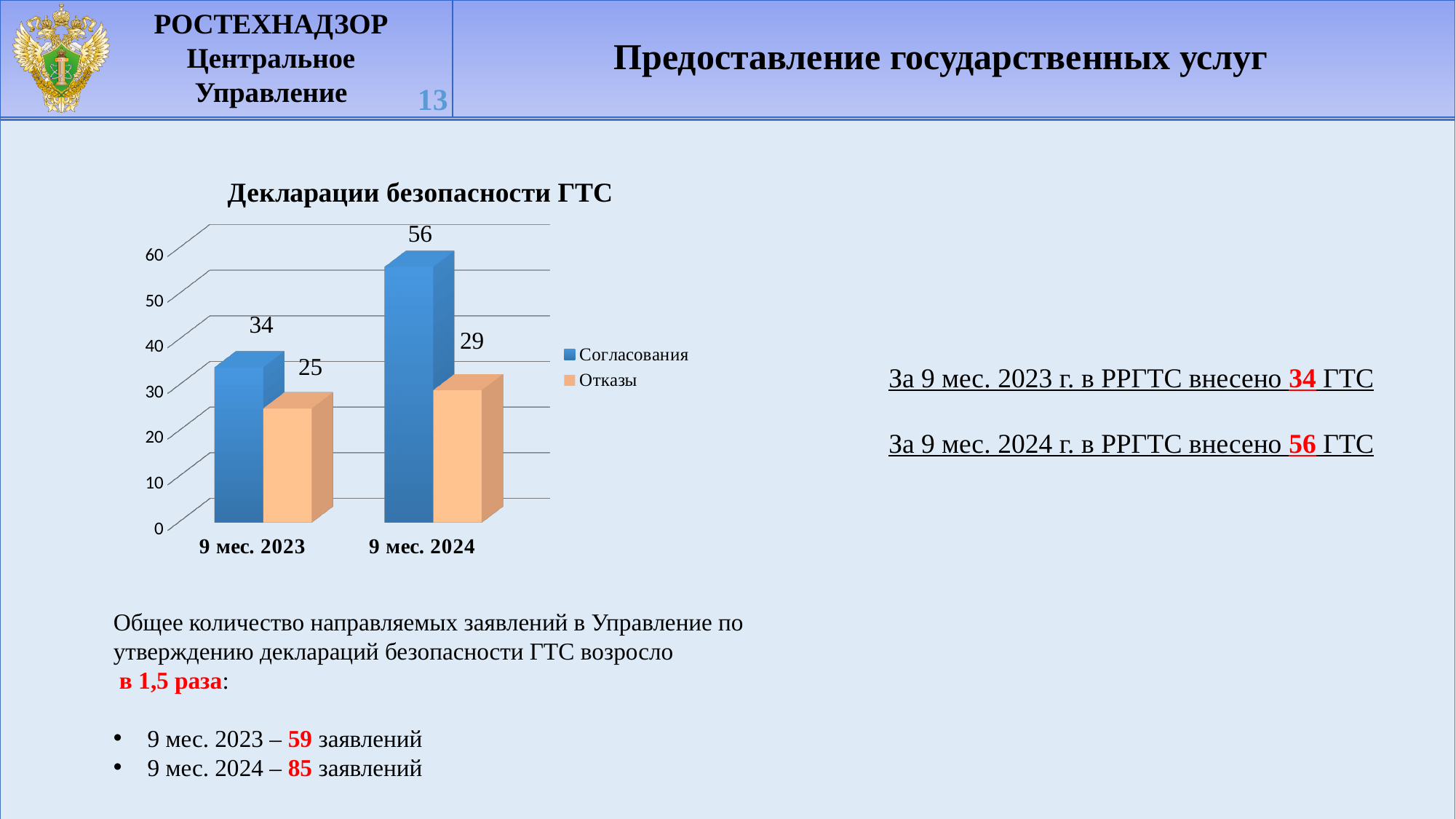
How many series does the legend list? 2 What is the value of Согласования for 9 мес. 2024? 56 What is the value of Отказы for 9 мес. 2023? 25 What is the difference between Согласования for 9 мес. 2024 and 9 мес. 2023? 22 What kind of chart is shown? bar chart Which category has the highest value for Согласования? 9 мес. 2024 What is the title of the chart? Декларации безопасности ГТС Which is larger: Согласования or Отказы for 9 мес. 2024? Согласования What is the value of Согласования for 9 мес. 2023? 34 How many categories are shown on the x axis? 2 Which category has the lowest value for Отказы? 9 мес. 2023 What is the value of Отказы for 9 мес. 2024? 29